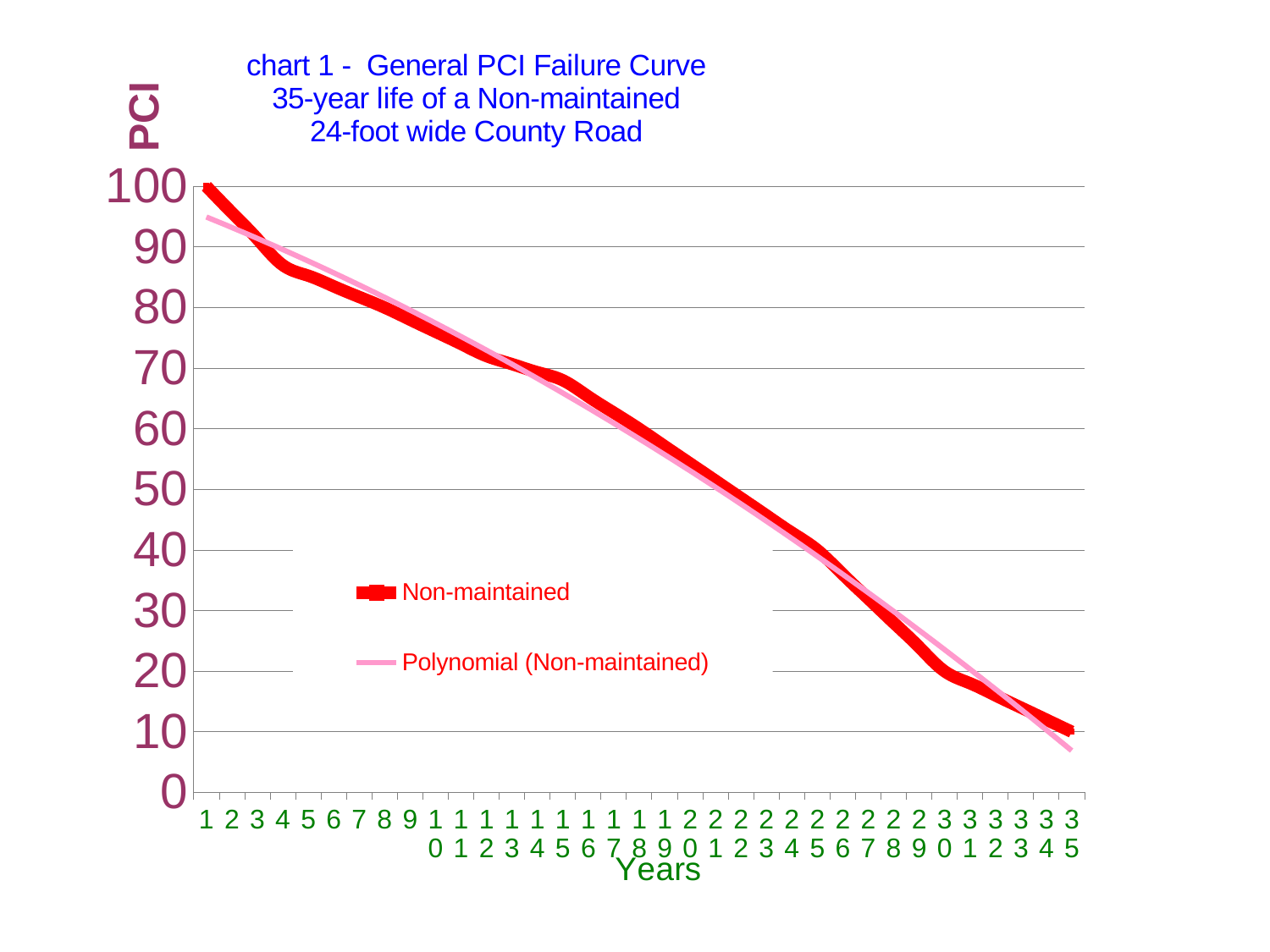
What is the label of the x axis? Years How many series does the legend list? 2 What is the Non-maintained PCI value in year 1? 100 Is the Non-maintained PCI value in year 30 greater or less than 30? less In which year is the Non-maintained PCI value lowest? 35 In which year is the Non-maintained PCI value highest? 1 Do the Non-maintained PCI values rise or fall as the years increase? fall Is the Non-maintained PCI value in year 20 greater or less than 60? less Is the Non-maintained PCI value in year 5 greater or less than 80? greater Which has the larger Non-maintained PCI value, year 5 or year 30? year 5 What kind of chart is shown on the slide? line chart How many years (points) are plotted along the x axis? 35